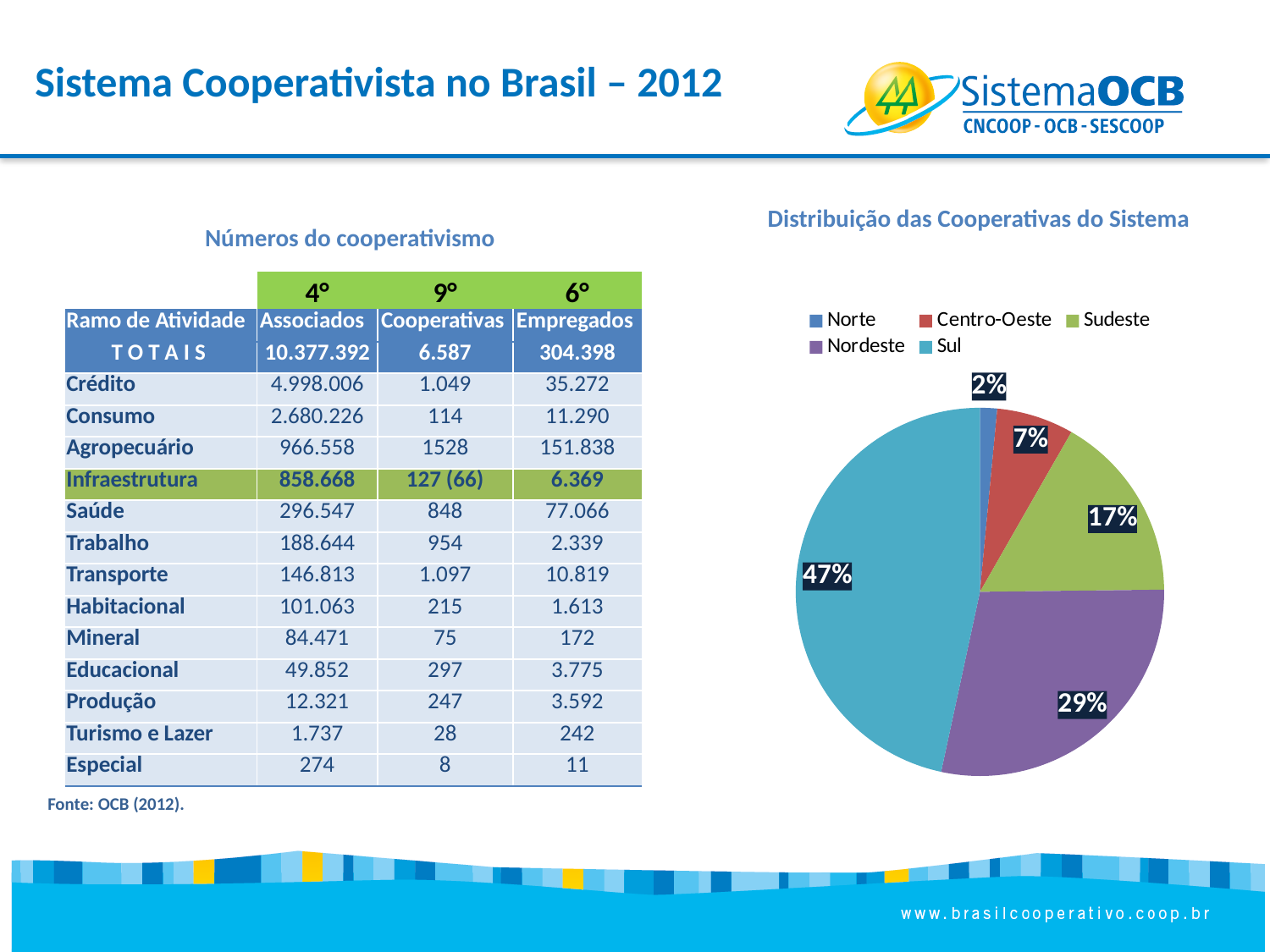
In the pie chart, what share of cooperatives is in the Nordeste region? 29% In the pie chart, what share of cooperatives is in the Sudeste region? 17% Which region has the largest slice in the pie chart? Sul In the pie chart, what share of cooperatives is in the Norte region? 2% How many regions does the legend of the pie chart list? 5 What is the title of the pie chart on the slide? Distribuição das Cooperativas do Sistema What kind of chart is shown under the title "Distribuição das Cooperativas do Sistema"? pie chart In the pie chart, which slice is larger: Sudeste or Centro-Oeste? Sudeste Which region has the smallest slice in the pie chart? Norte In the pie chart, what share of cooperatives is in the Centro-Oeste region? 7% In the pie chart, what share of cooperatives is in the Sul region? 47% In the pie chart, what is the difference in percentage points between the Sul and Nordeste slices? 18